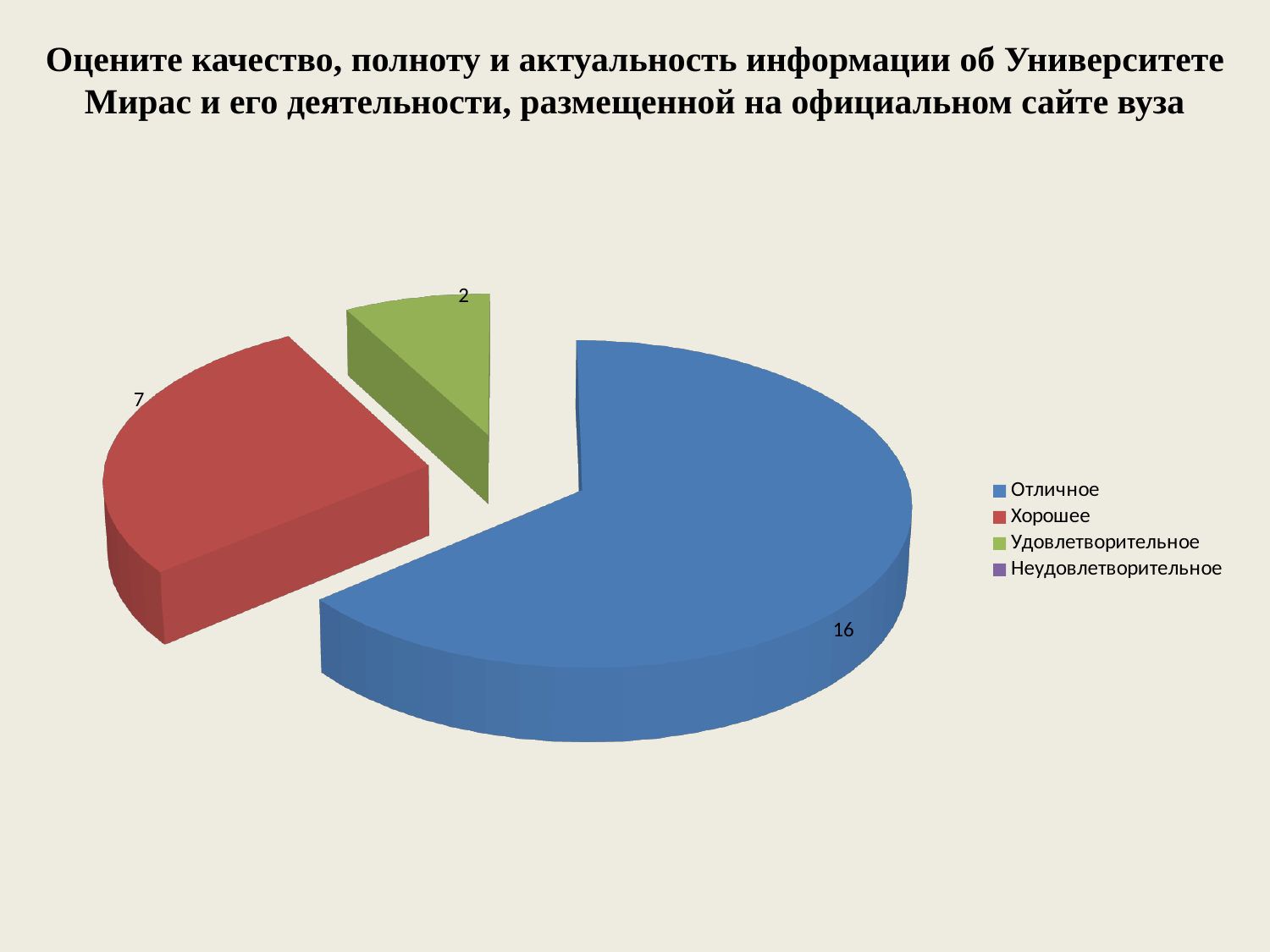
How many slices have a data label printed on the chart? 3 What is the value for Отличное? 16 Which is larger, the value for Хорошее or the value for Удовлетворительное? Хорошее Which labelled slice has the smallest value? Удовлетворительное What is the difference between the values for Хорошее and Удовлетворительное? 5 What type of chart is shown on the slide? pie chart What is the value for Удовлетворительное? 2 What colour is the slice for Отличное? blue What is the difference between the values for Отличное and Хорошее? 9 How many entries does the legend list? 4 What is the value for Хорошее? 7 Which category has the largest slice of the pie? Отличное